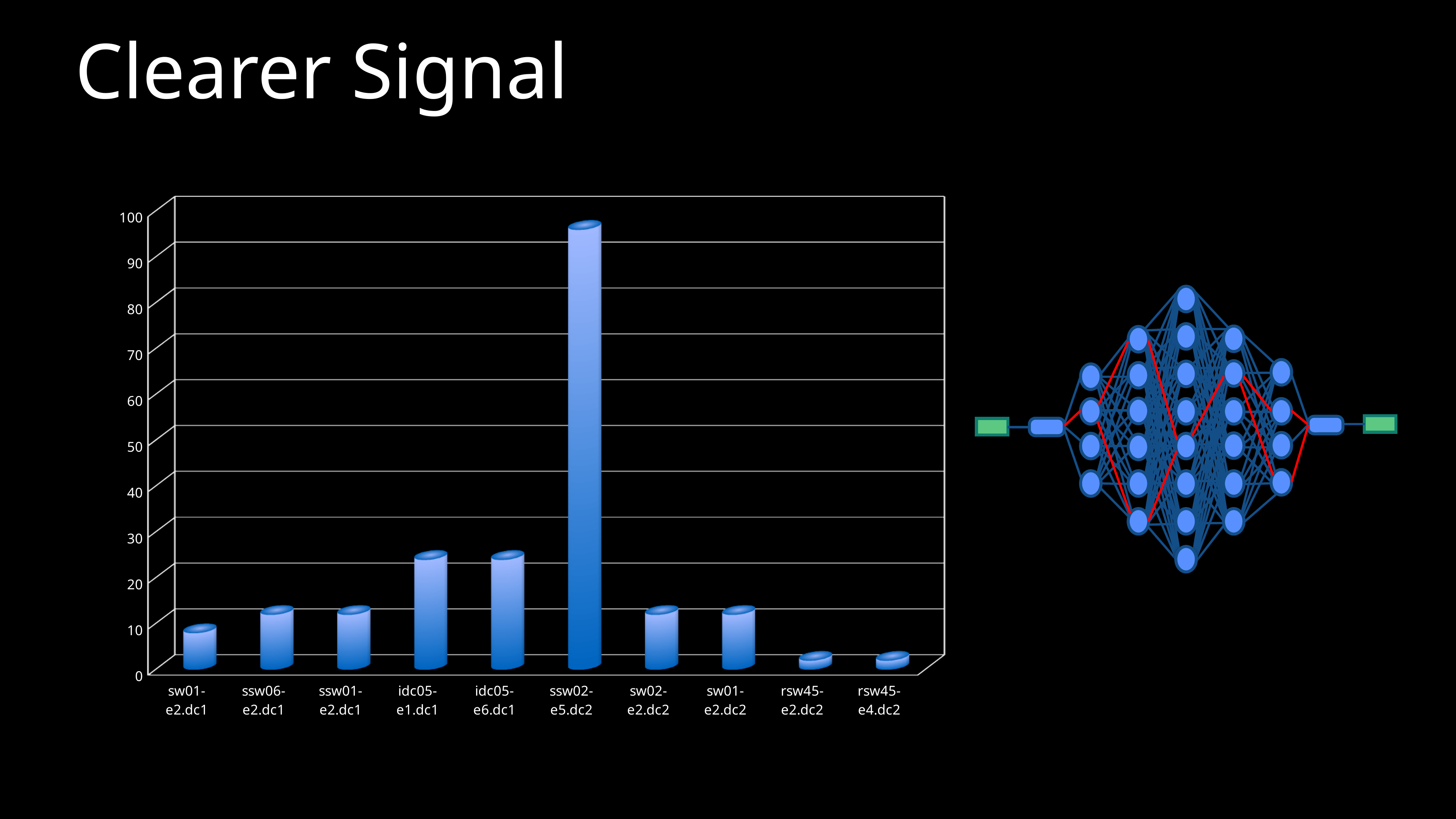
Which is larger, the value for ssw06-e2.dc1 or the value for rsw45-e4.dc2? ssw06-e2.dc1 What kind of chart is shown on the slide? bar chart Is the value for idc05-e6.dc1 greater or less than 50? less What is the highest tick value shown on the vertical axis of the chart? 100 Is the value for idc05-e1.dc1 greater or less than 20? greater Is the value for sw01-e2.dc1 greater or less than 20? less How many categories are plotted on the x axis of the chart? 10 Which is larger, the value for ssw02-e5.dc2 or the value for idc05-e1.dc1? ssw02-e5.dc2 Which is larger, the value for idc05-e6.dc1 or the value for sw01-e2.dc1? idc05-e6.dc1 Which category has the highest value in the chart? ssw02-e5.dc2